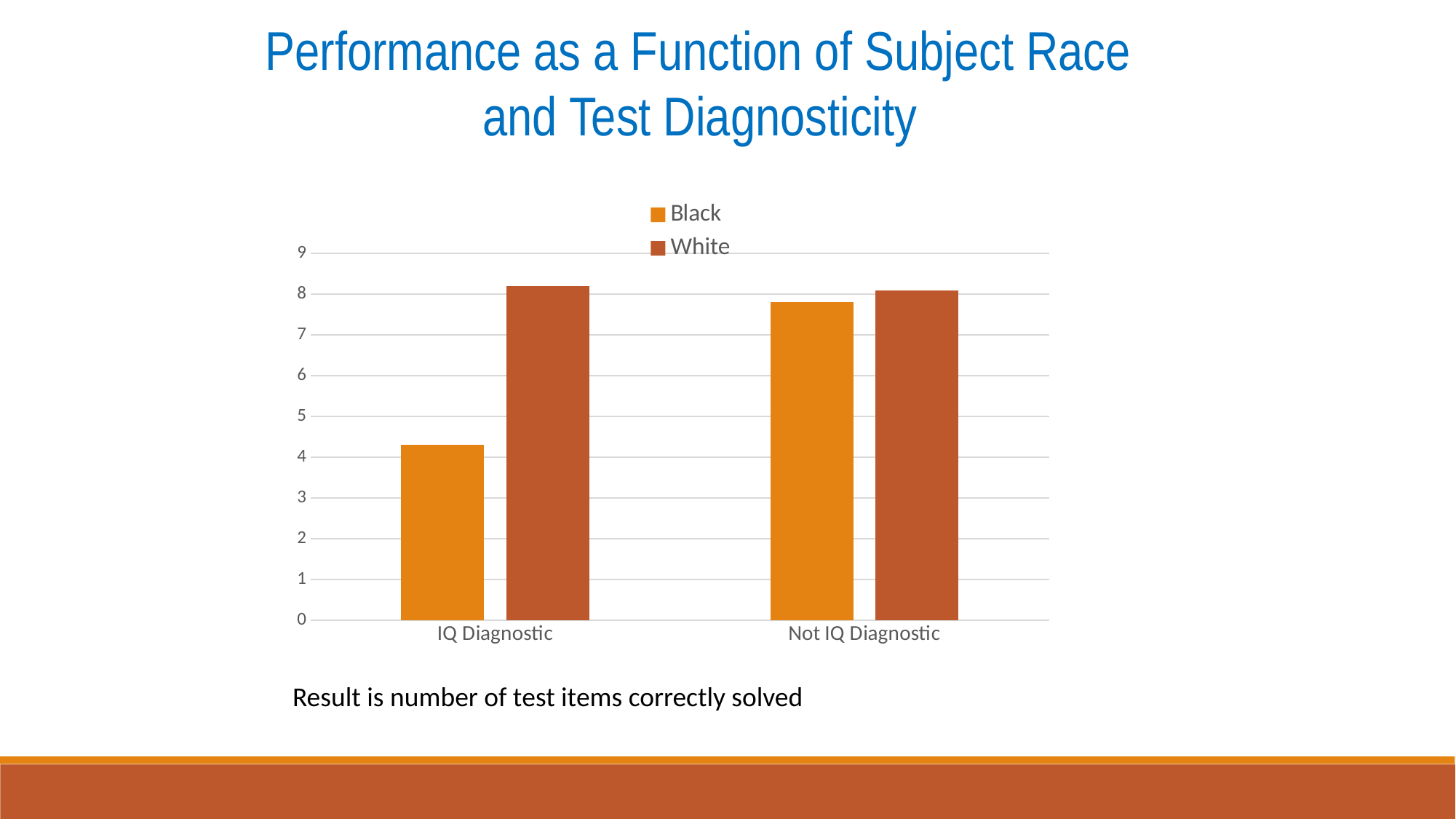
Is the White value for Not IQ Diagnostic greater or less than 6? greater How many series does the legend list? 2 Is the Black value for Not IQ Diagnostic greater or less than 7? greater What kind of chart is shown on the slide? bar chart Is the White value for IQ Diagnostic greater or less than 7? greater For the Black series, which is larger, the IQ Diagnostic or the Not IQ Diagnostic value? Not IQ Diagnostic Which series is shown in the lighter orange colour? Black For the IQ Diagnostic condition, which is larger, the Black or the White value? White How many categories are shown on the x axis? 2 What is the title of the chart on the slide? Performance as a Function of Subject Race and Test Diagnosticity Which bar is the lowest in the chart? Black, IQ Diagnostic